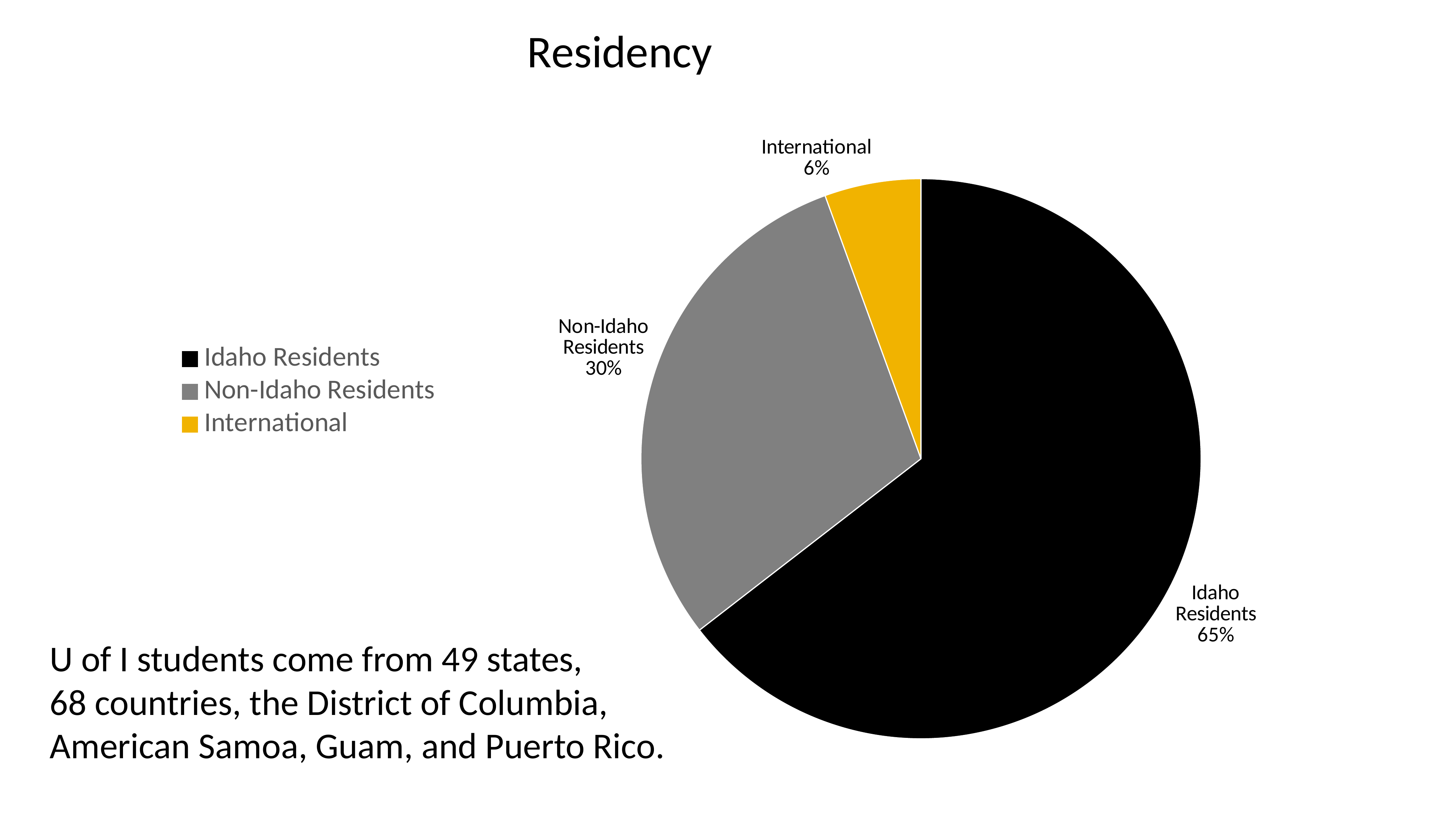
Which category has the smallest slice? International How many slices does the pie chart have? 3 What share of the pie is Idaho Residents? 65% What share of the pie is Non-Idaho Residents? 30% What is the title of the chart? Residency What share of the pie is International? 6% What colour is the International slice? yellow Which category has the largest slice? Idaho Residents Which is larger, Non-Idaho Residents or International? Non-Idaho Residents What is the difference in percentage points between Idaho Residents and Non-Idaho Residents? 35 How many entries does the legend list? 3 What kind of chart is shown on the slide? pie chart